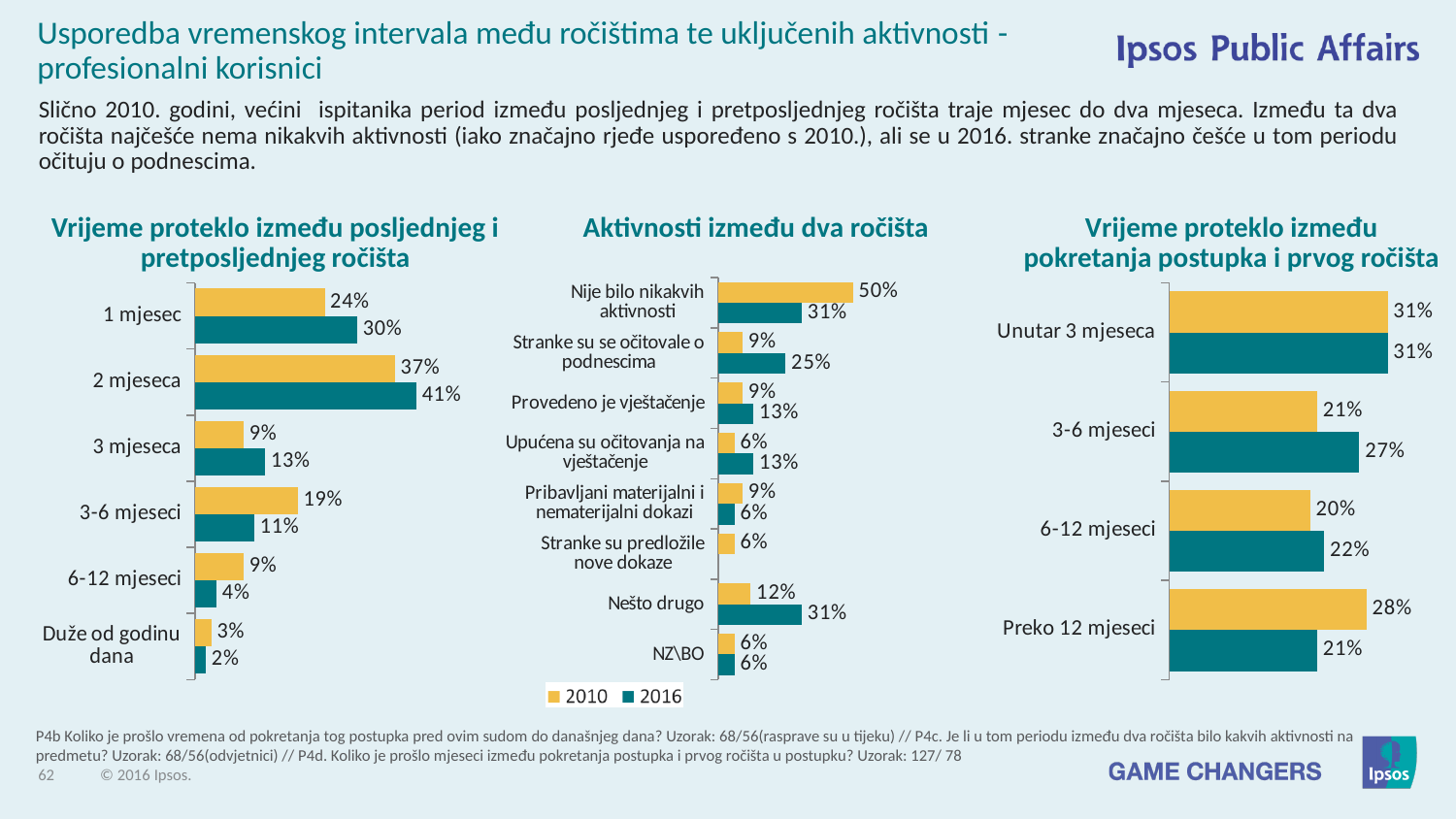
In the chart 'Aktivnosti između dva ročišta', what is the 2016 value for 'Stranke su se očitovale o podnescima'? 25% In the chart 'Vrijeme proteklo između posljednjeg i pretposljednjeg ročišta', which category has the highest 2010 value? 2 mjeseca In the chart 'Vrijeme proteklo između pokretanja postupka i prvog ročišta', what is the difference between the 2010 and 2016 values for 'Preko 12 mjeseci'? 7% In the chart 'Aktivnosti između dva ročišta', how many series does the legend list? 2 In the chart 'Vrijeme proteklo između posljednjeg i pretposljednjeg ročišta', how many categories are shown? 6 In the chart 'Vrijeme proteklo između posljednjeg i pretposljednjeg ročišta', what is the 2016 value for '2 mjeseca'? 41% In the chart 'Vrijeme proteklo između pokretanja postupka i prvog ročišta', which category has the lowest 2010 value? 6-12 mjeseci In the chart 'Aktivnosti između dva ročišta', which is larger for 'Nešto drugo': the 2010 value or the 2016 value? 2016 In the chart 'Aktivnosti između dva ročišta', what is the 2010 value for 'Nije bilo nikakvih aktivnosti'? 50% In the chart 'Vrijeme proteklo između pokretanja postupka i prvog ročišta', what is the 2016 value for '3-6 mjeseci'? 27% In the chart 'Vrijeme proteklo između posljednjeg i pretposljednjeg ročišta', what is the difference between the 2010 and 2016 values for '3-6 mjeseci'? 8% What type of chart is 'Vrijeme proteklo između pokretanja postupka i prvog ročišta'? Bar chart